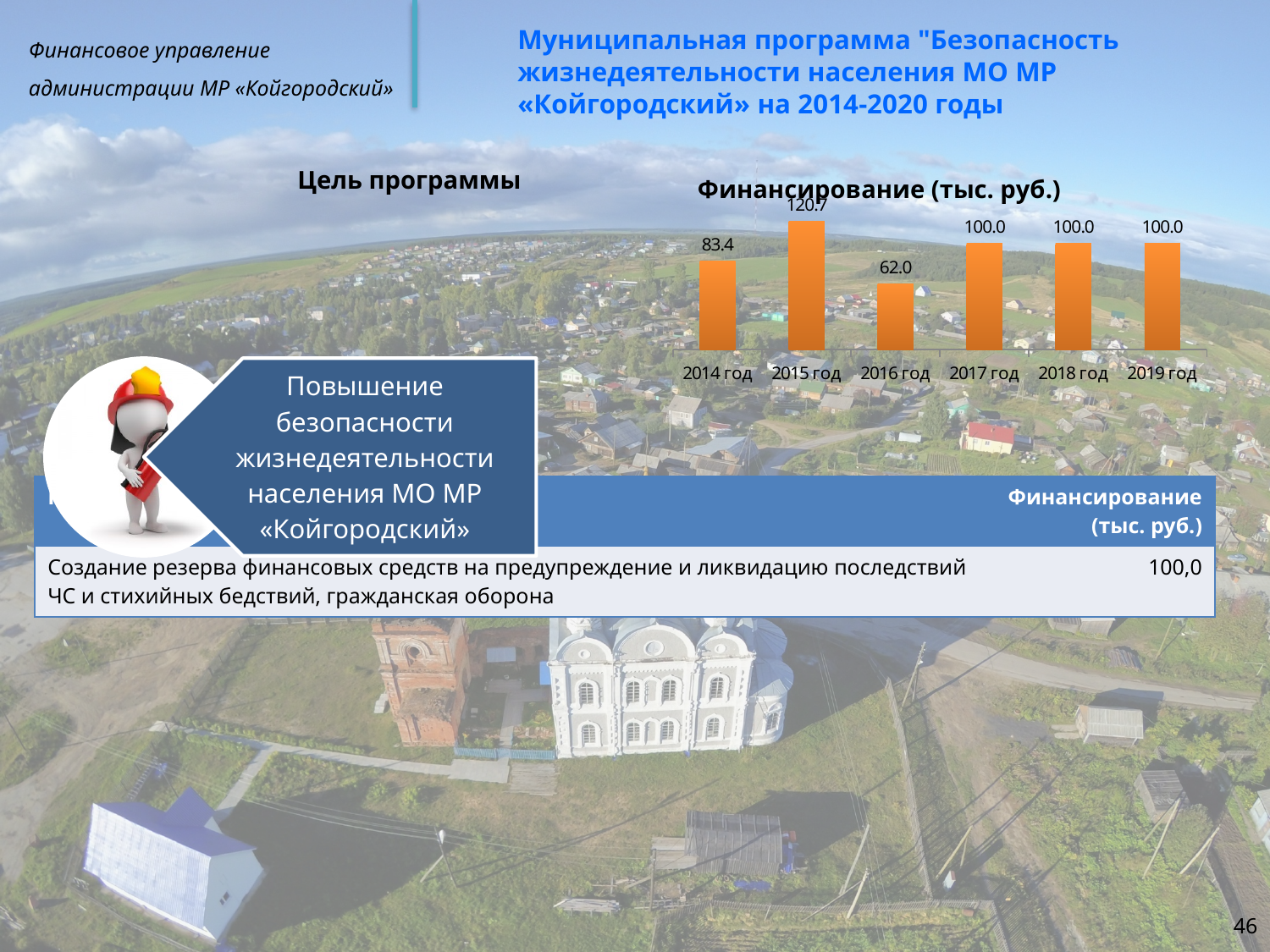
What is the value for 2014 год in the chart "Финансирование (тыс. руб.)"? 83.4 What is the value for 2018 год in the chart "Финансирование (тыс. руб.)"? 100.0 What is the value for 2015 год in the chart "Финансирование (тыс. руб.)"? 120.7 Which is larger in the chart "Финансирование (тыс. руб.)": the value for 2014 год or the value for 2016 год? 2014 год What is the difference between the values for 2017 год and 2014 год in the chart "Финансирование (тыс. руб.)"? 16.6 What is the value for 2016 год in the chart "Финансирование (тыс. руб.)"? 62.0 Which year has the highest value in the chart "Финансирование (тыс. руб.)"? 2015 год How many years are shown on the x axis of the chart "Финансирование (тыс. руб.)"? 6 Which year has the lowest value in the chart "Финансирование (тыс. руб.)"? 2016 год What is the title of the chart on the slide? Финансирование (тыс. руб.) What kind of chart is "Финансирование (тыс. руб.)"? Bar chart What is the difference between the values for 2015 год and 2016 год in the chart "Финансирование (тыс. руб.)"? 58.7